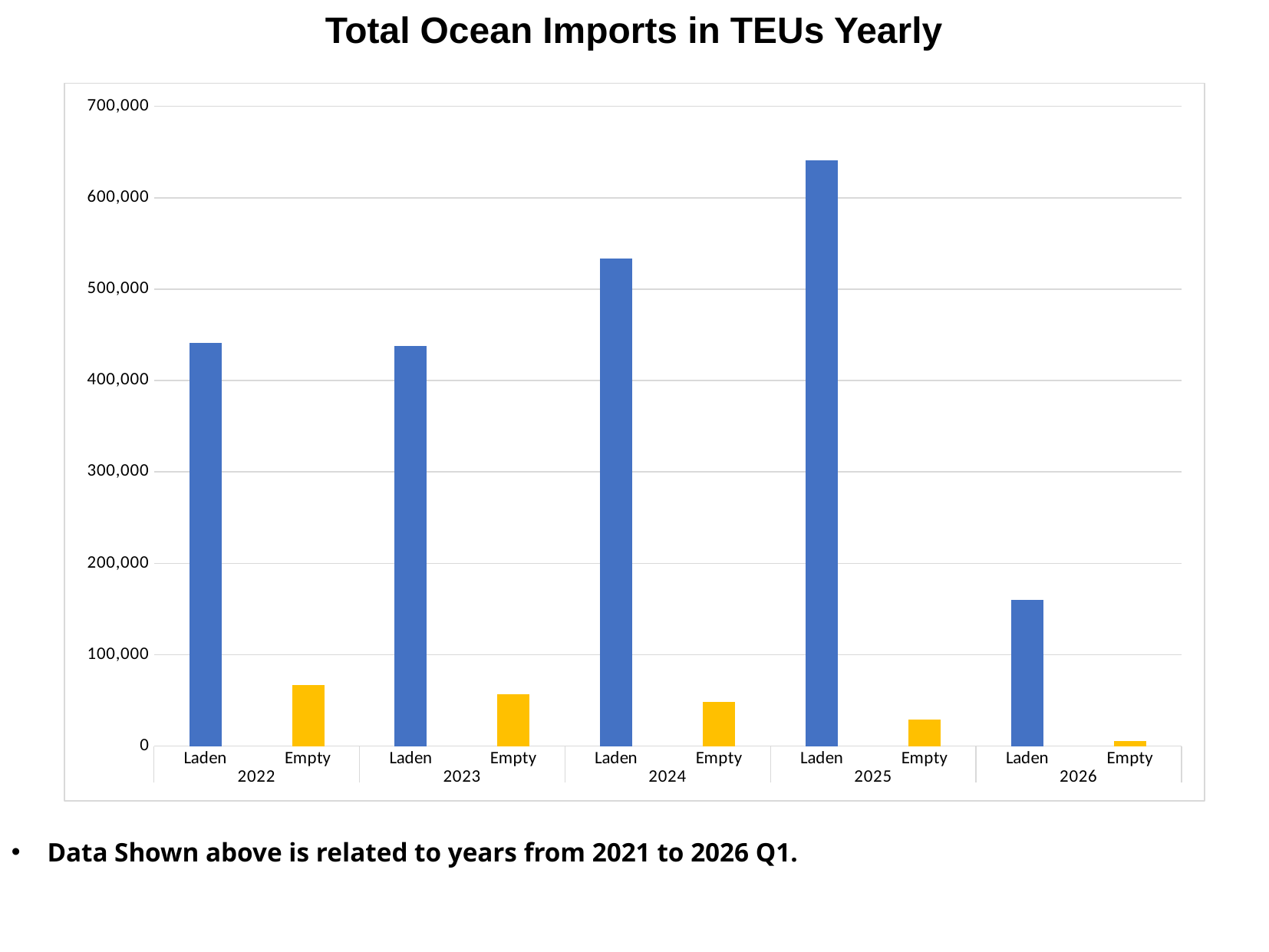
What kind of chart is shown on the slide? bar chart Is the value for Laden 2024 greater or less than 500,000? greater Is the value for Laden 2026 greater or less than 200,000? less Is the value for Laden 2025 greater or less than 600,000? greater How many bars are plotted in the chart? 10 What is the title of the chart? Total Ocean Imports in TEUs Yearly How many years are shown on the x axis? 5 Which bar is the highest in the chart? Laden 2025 Which is larger, Laden 2024 or Laden 2025? Laden 2025 Which bar is the lowest in the chart? Empty 2026 Do the Empty values rise or fall from 2022 to 2026? fall